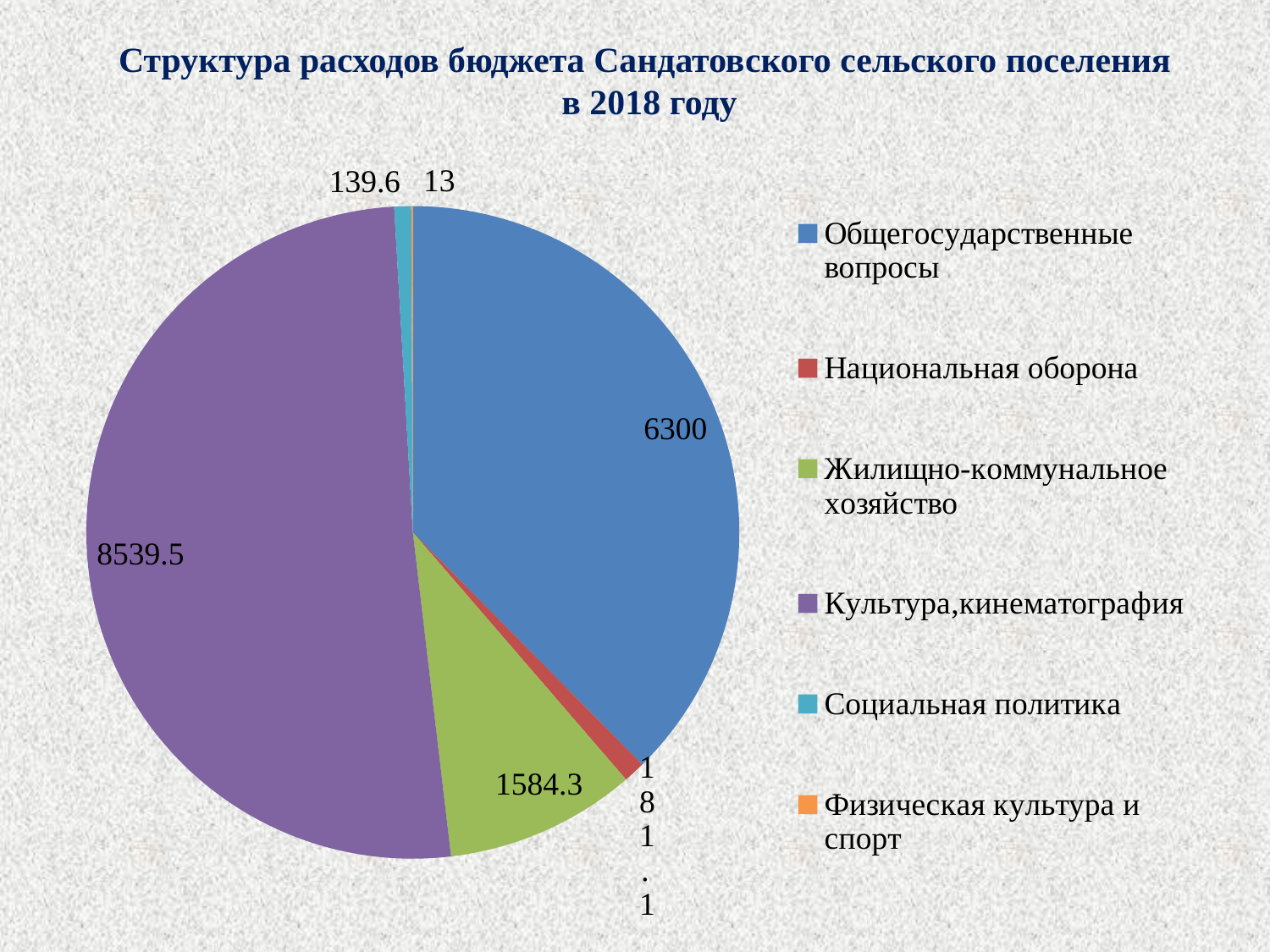
What colour is the slice for Общегосударственные вопросы? blue What is the value for Общегосударственные вопросы? 6300 Which category has the largest slice of the pie? Культура,кинематография What type of chart is shown on the slide? pie chart What is the value for Социальная политика? 139.6 What is the value for Культура,кинематография? 8539.5 Which is larger: the value for Жилищно-коммунальное хозяйство or the value for Социальная политика? Жилищно-коммунальное хозяйство How many categories does the legend list? 6 What is the value for Жилищно-коммунальное хозяйство? 1584.3 What is the difference between the values for Культура,кинематография and Общегосударственные вопросы? 2239.5 What is the value for Физическая культура и спорт? 13 Which category has the smallest slice of the pie? Физическая культура и спорт